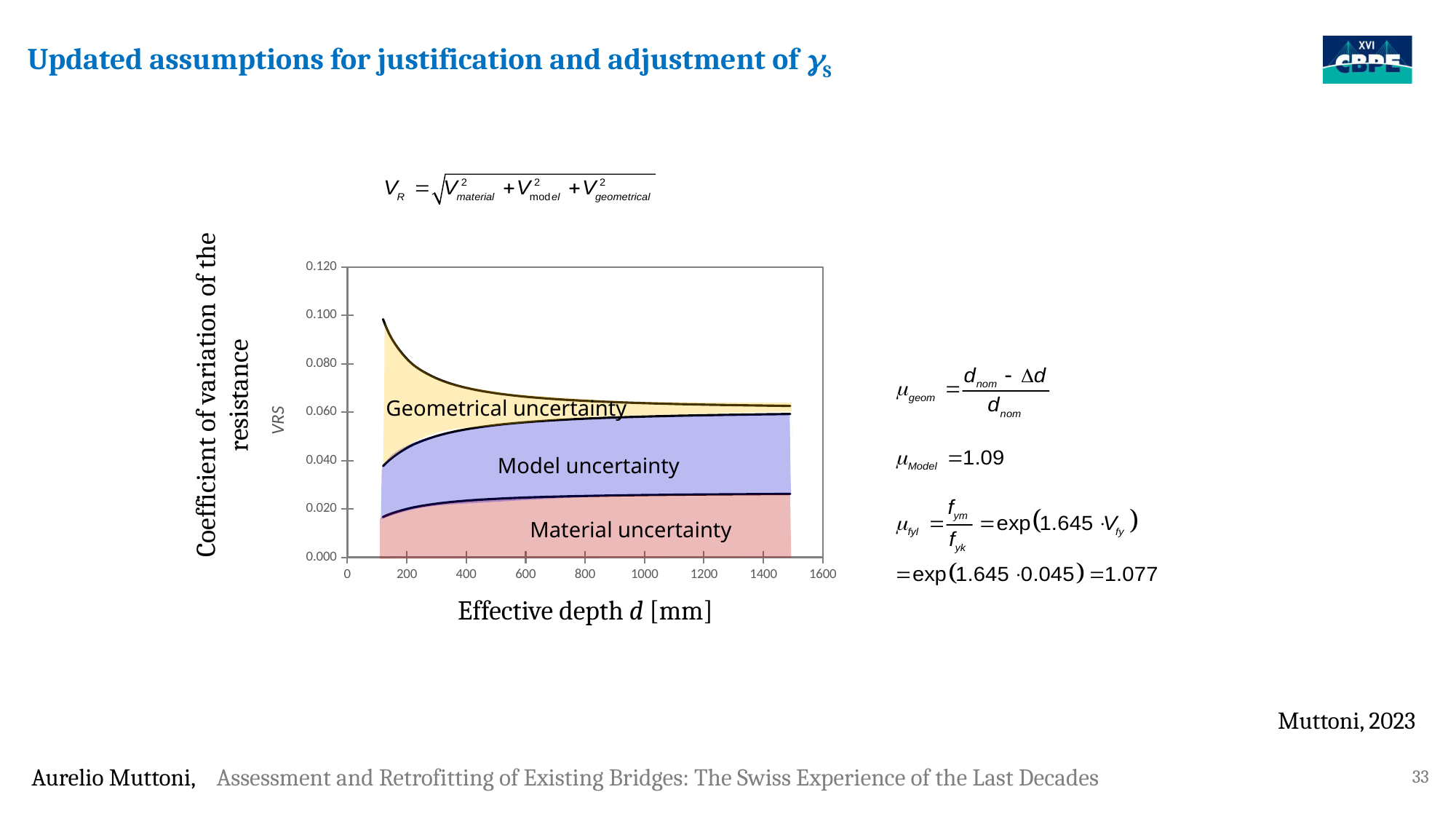
At an effective depth of 1400 mm, is the upper boundary of the material uncertainty band greater or less than 0.040? less At an effective depth of 1400 mm, is the total coefficient of variation greater or less than 0.080? less How many uncertainty components are stacked in the chart? 3 What kind of chart is shown on the slide? Area chart Which uncertainty component forms the top band of the chart? Geometrical uncertainty Does the total coefficient of variation of the resistance rise or fall as the effective depth increases? Fall Which uncertainty component forms the bottom band of the chart? Material uncertainty At an effective depth of 1400 mm, is the upper boundary of the model uncertainty band greater or less than 0.040? greater Does the upper boundary of the material uncertainty band rise or fall as the effective depth increases? Rise